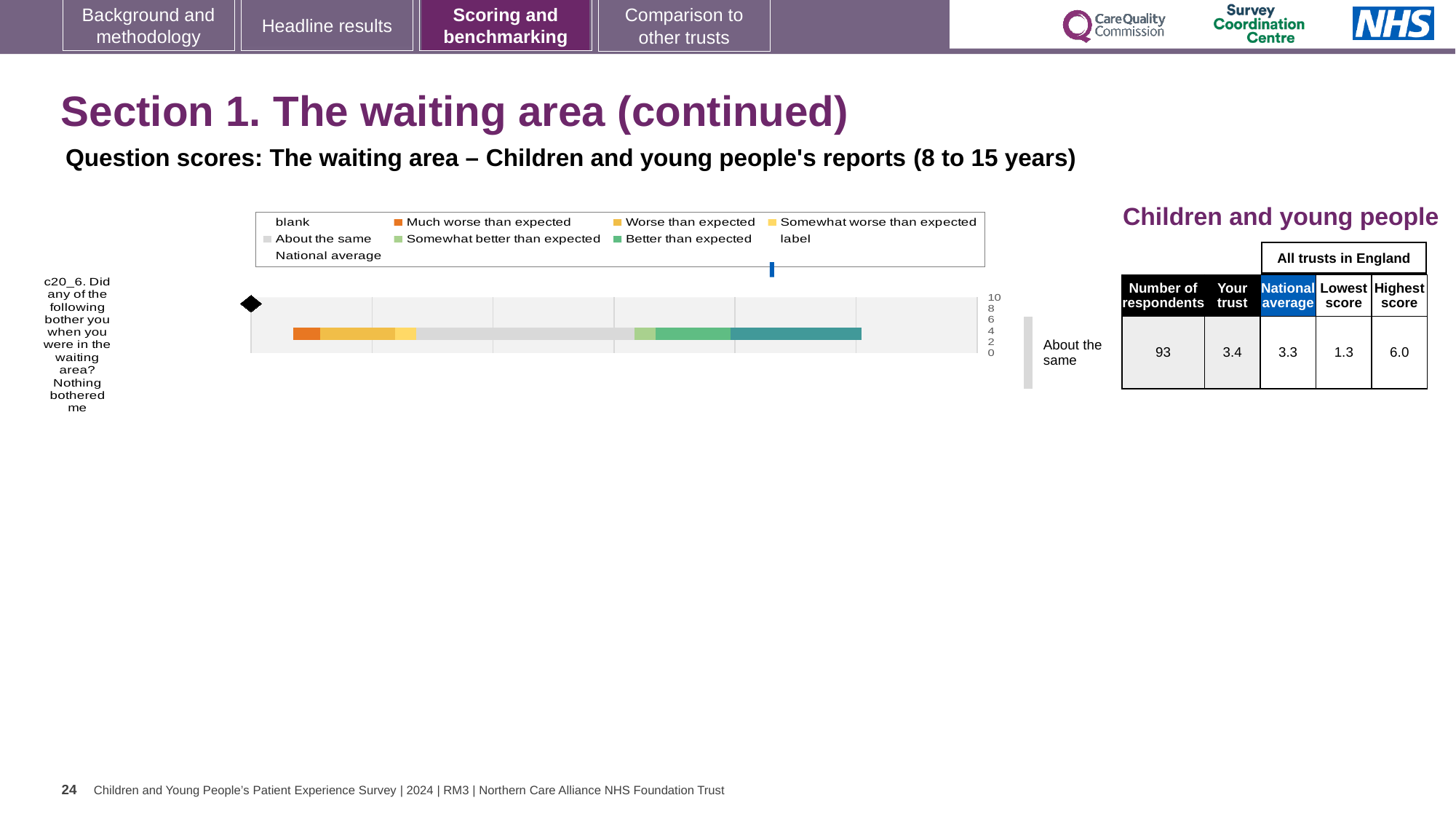
What kind of chart is shown on the slide? bar chart What benchmark category is shown next to the bar for question c20_6? About the same What is the lowest score across all trusts in England for question c20_6? 1.3 What is the national average score for question c20_6 in the table? 3.3 What colour is the 'Much worse than expected' band in the chart legend? orange What is the 'Your trust' score for question c20_6 in the table? 3.4 What is the highest score across all trusts in England for question c20_6? 6.0 How many respondents are listed for question c20_6? 93 Which question is plotted in the bar chart? c20_6. Did any of the following bother you when you were in the waiting area? Nothing bothered me How many questions (categories) are plotted in the bar chart? 1 What is the difference between the highest score and the lowest score for question c20_6? 4.7 Which is larger for question c20_6, the 'Your trust' score or the national average? Your trust